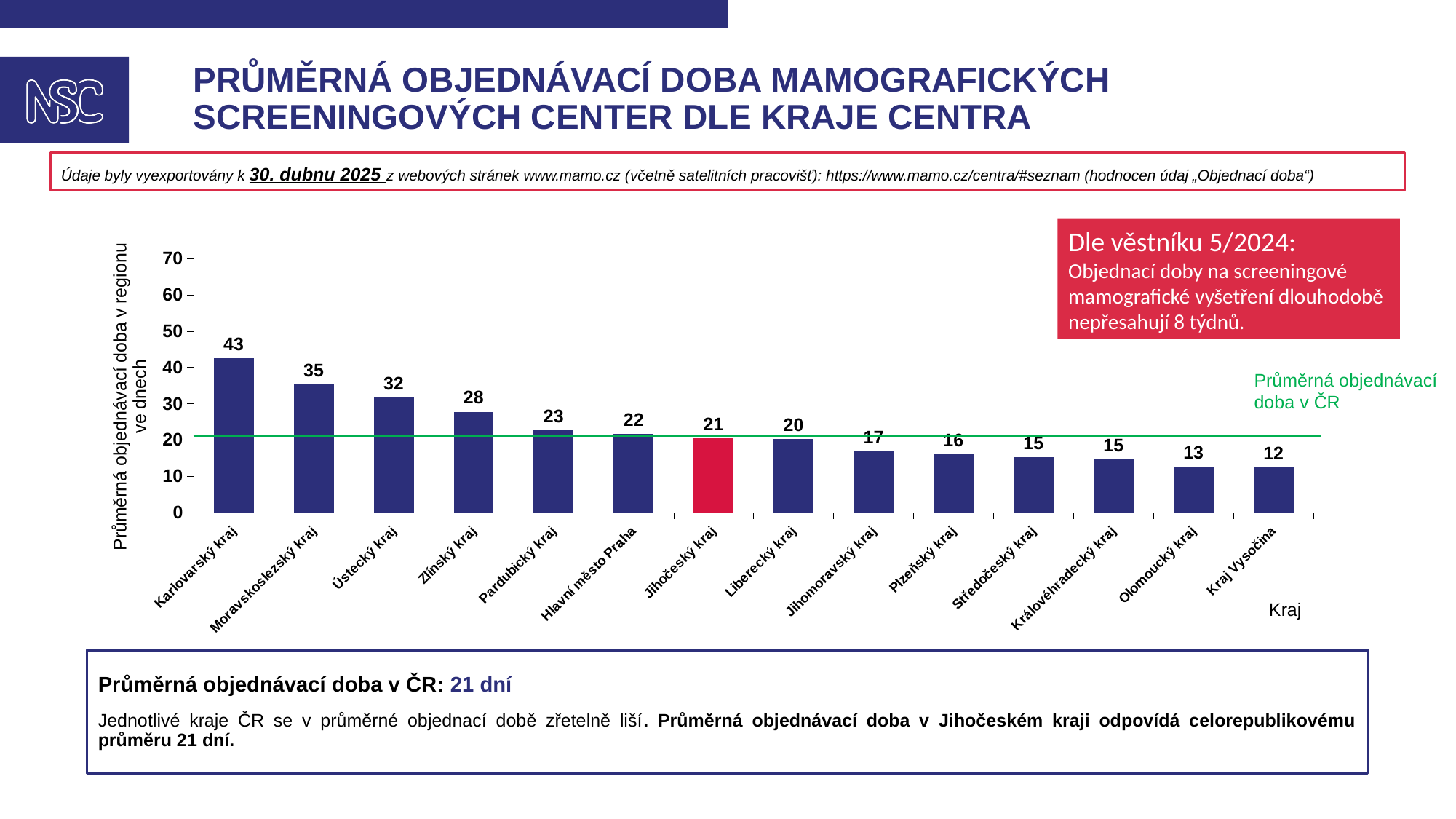
What kind of chart is shown on the slide? bar chart Which has a larger value, Ústecký kraj or Zlínský kraj? Ústecký kraj Which region has the highest average ordering time? Karlovarský kraj What is the value shown for Jihočeský kraj? 21 Which region has the lowest average ordering time? Kraj Vysočina Which region's bar is highlighted in red? Jihočeský kraj What is the average ordering time for Karlovarský kraj? 43 Do the values rise or fall from left to right along the x axis? fall What is the value shown for Hlavní město Praha? 22 How many regions are shown on the x axis of the chart? 14 What is the difference between the values for Karlovarský kraj and Moravskoslezský kraj? 8 Is the value for Liberecký kraj greater or less than 30? less